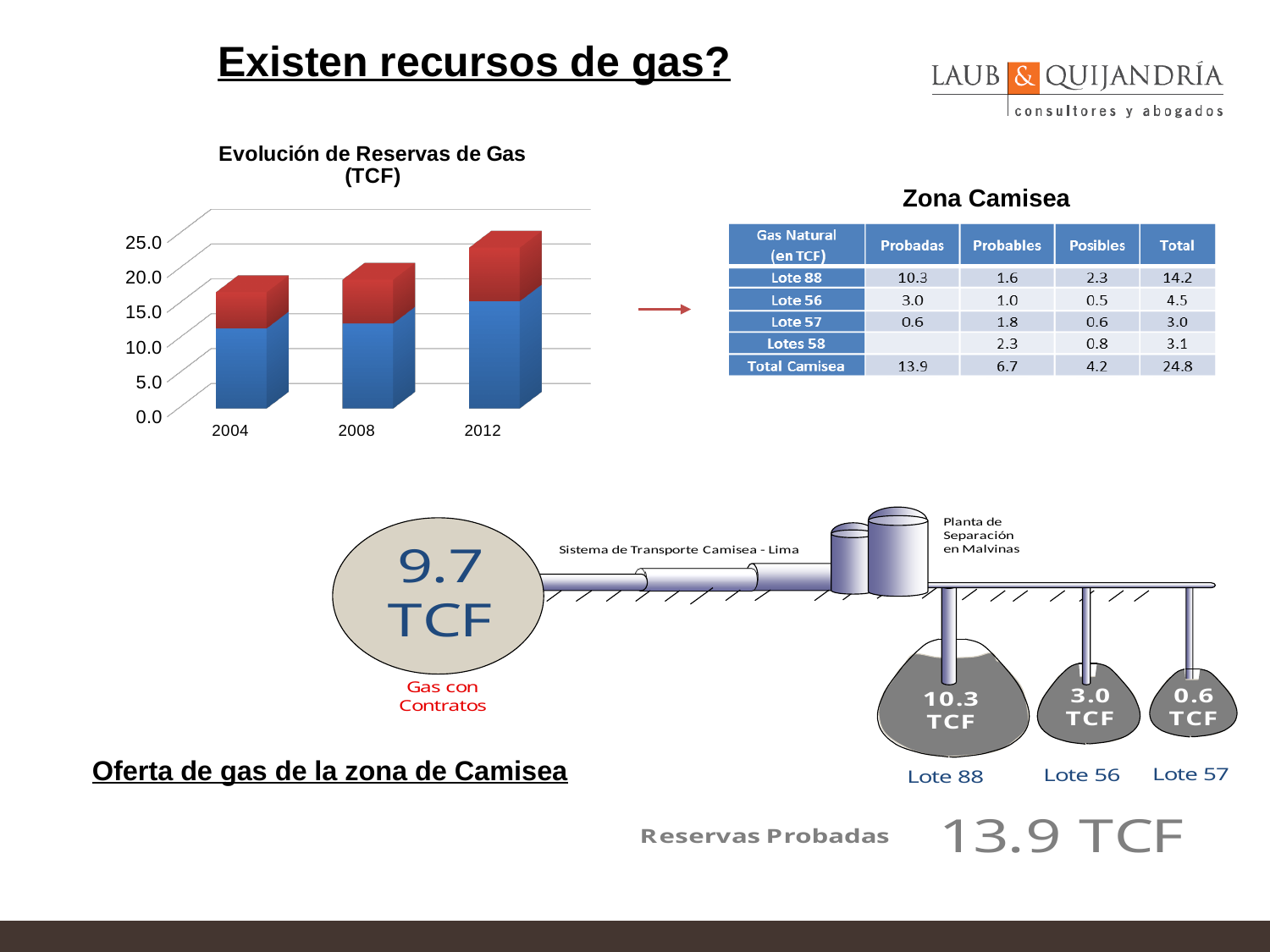
In the 'Evolución de Reservas de Gas (TCF)' chart, is the total bar height for 2004 greater or less than 10.0? greater What is the title of the bar chart on the slide? Evolución de Reservas de Gas (TCF) Which year has the shortest bar in the 'Evolución de Reservas de Gas (TCF)' chart? 2004 How many years are shown on the x axis of the 'Evolución de Reservas de Gas (TCF)' chart? 3 What two colours are used for the stacked segments in the 'Evolución de Reservas de Gas (TCF)' chart? blue and red In the 'Evolución de Reservas de Gas (TCF)' chart, which bar is taller, 2004 or 2012? 2012 In the 'Evolución de Reservas de Gas (TCF)' chart, is the total bar height for 2008 greater or less than 15.0? greater In the 'Evolución de Reservas de Gas (TCF)' chart, do the total bar heights rise or fall from 2004 to 2012? rise In the 'Evolución de Reservas de Gas (TCF)' chart, is the total bar height for 2012 greater or less than 20.0? greater What kind of chart is 'Evolución de Reservas de Gas (TCF)'? bar chart Which year has the tallest bar in the 'Evolución de Reservas de Gas (TCF)' chart? 2012